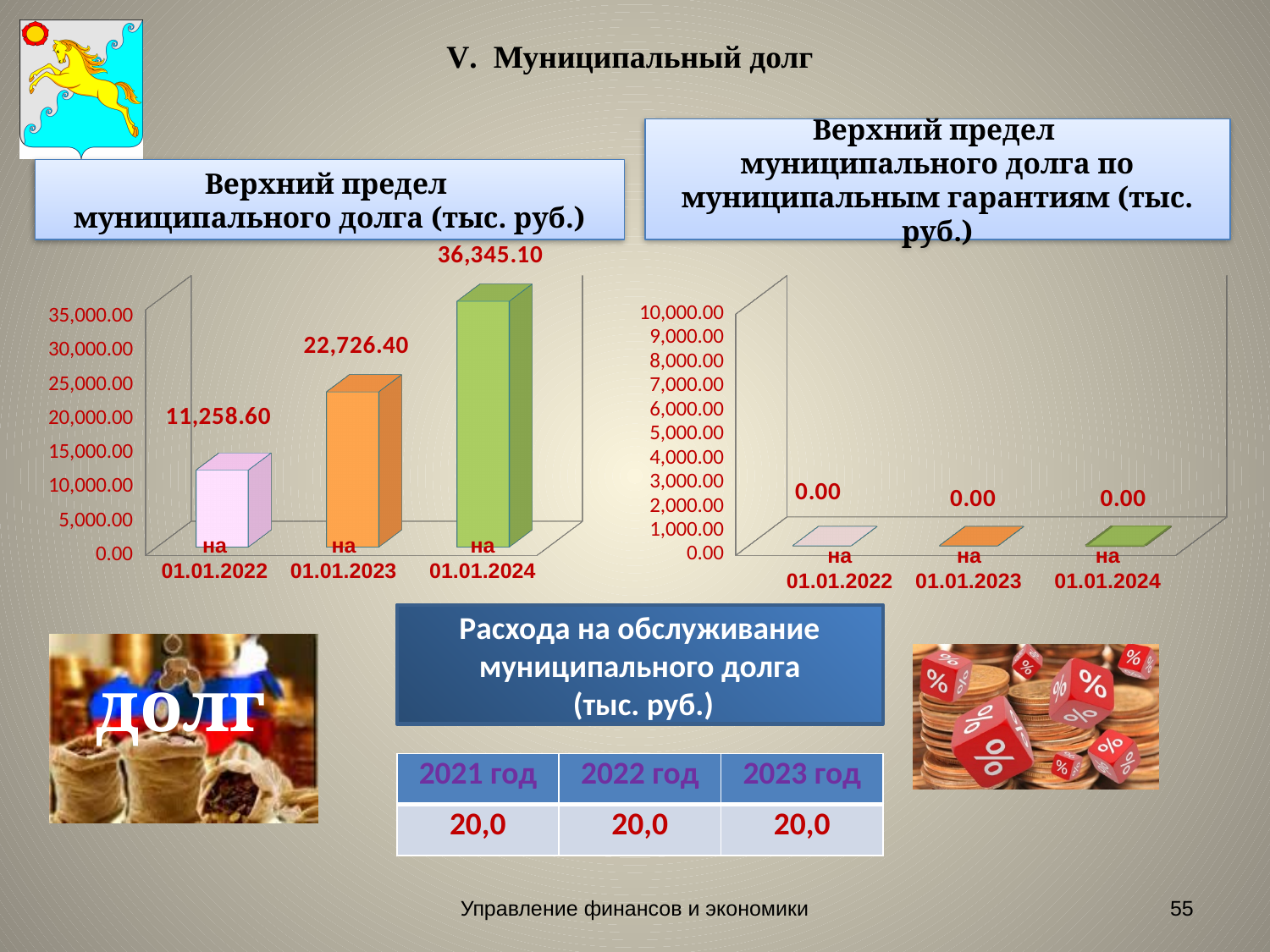
In the chart 'Верхний предел муниципального долга (тыс. руб.)', what is the value for на 01.01.2024? 36,345.10 In the chart 'Верхний предел муниципального долга (тыс. руб.)', which date has the lowest value? на 01.01.2022 In the chart 'Верхний предел муниципального долга (тыс. руб.)', which date has the highest value? на 01.01.2024 In the chart 'Верхний предел муниципального долга (тыс. руб.)', what is the difference between the values for на 01.01.2023 and на 01.01.2022? 11,467.80 In the chart 'Верхний предел муниципального долга (тыс. руб.)', what is the value for на 01.01.2023? 22,726.40 In the chart 'Верхний предел муниципального долга (тыс. руб.)', do the values rise or fall from 01.01.2022 to 01.01.2024? rise In the chart 'Верхний предел муниципального долга (тыс. руб.)', how many bars are plotted? 3 In the chart 'Верхний предел муниципального долга по муниципальным гарантиям (тыс. руб.)', what is the value for на 01.01.2023? 0.00 What kind of chart is 'Верхний предел муниципального долга по муниципальным гарантиям (тыс. руб.)'? bar chart In the chart 'Верхний предел муниципального долга по муниципальным гарантиям (тыс. руб.)', what is the highest value shown on the vertical axis? 10,000.00 In the chart 'Верхний предел муниципального долга (тыс. руб.)', what is the difference between the values for на 01.01.2024 and на 01.01.2023? 13,618.70 In the chart 'Верхний предел муниципального долга (тыс. руб.)', what is the value for на 01.01.2022? 11,258.60